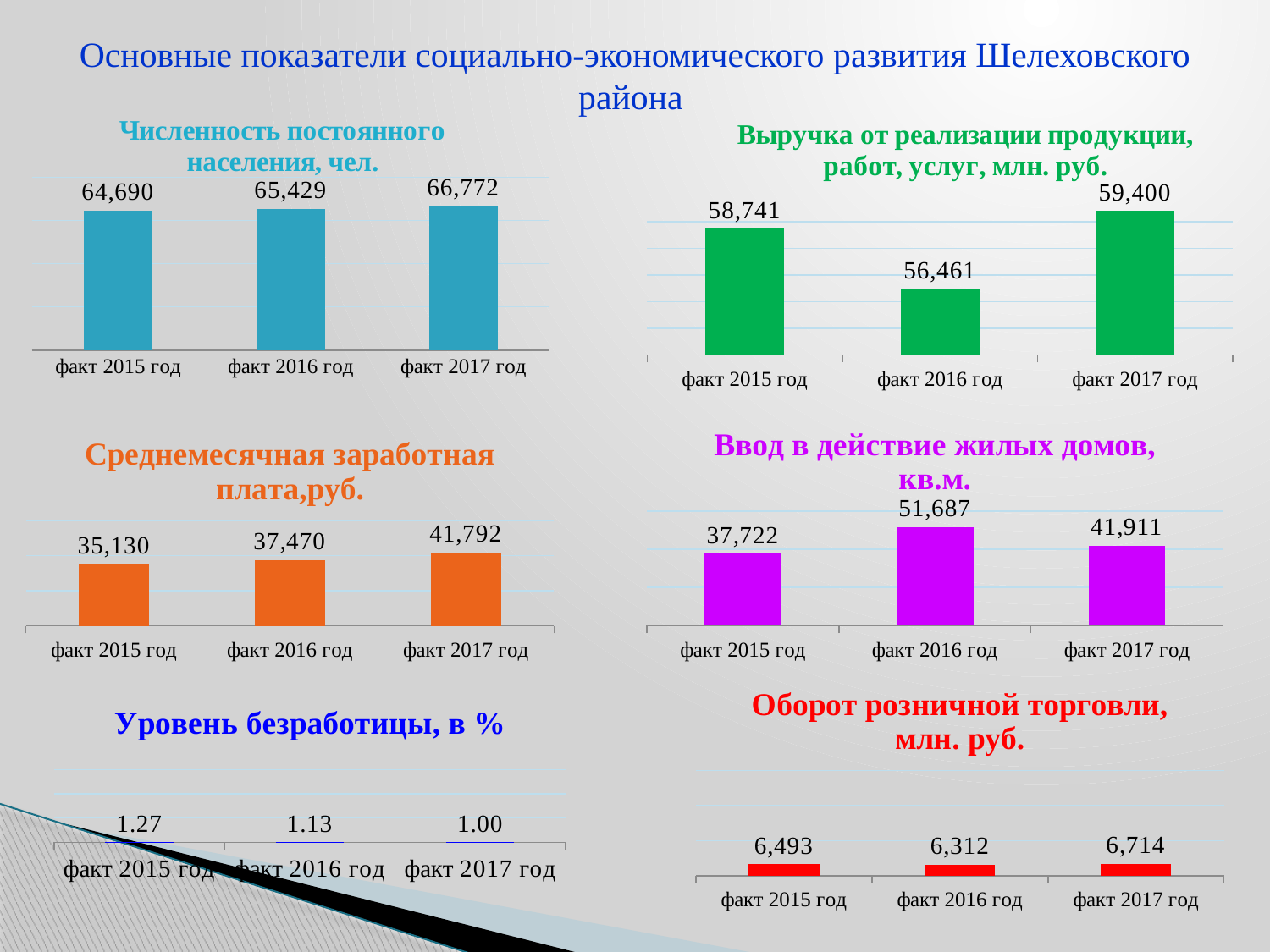
In the chart 'Среднемесячная заработная плата, руб.', what is the difference between факт 2017 год and факт 2015 год? 6,662 In the chart 'Выручка от реализации продукции, работ, услуг, млн. руб.', which year has the lowest value? факт 2016 год In the chart 'Выручка от реализации продукции, работ, услуг, млн. руб.', what is the value for факт 2015 год? 58,741 In the chart 'Уровень безработицы, в %', do the values rise or fall from факт 2015 год to факт 2017 год? fall In the chart 'Ввод в действие жилых домов, кв.м.', which year has the highest value? факт 2016 год How many bars are in the chart 'Оборот розничной торговли, млн. руб.'? 3 In the chart 'Оборот розничной торговли, млн. руб.', which is larger: факт 2015 год or факт 2016 год? факт 2015 год In the chart 'Численность постоянного населения, чел.', what is the value for факт 2017 год? 66,772 What type of chart is 'Численность постоянного населения, чел.'? bar chart In the chart 'Уровень безработицы, в %', what is the value for факт 2016 год? 1.13 In the chart 'Среднемесячная заработная плата, руб.', do the values rise or fall from факт 2015 год to факт 2017 год? rise In the chart 'Ввод в действие жилых домов, кв.м.', what is the value for факт 2017 год? 41,911